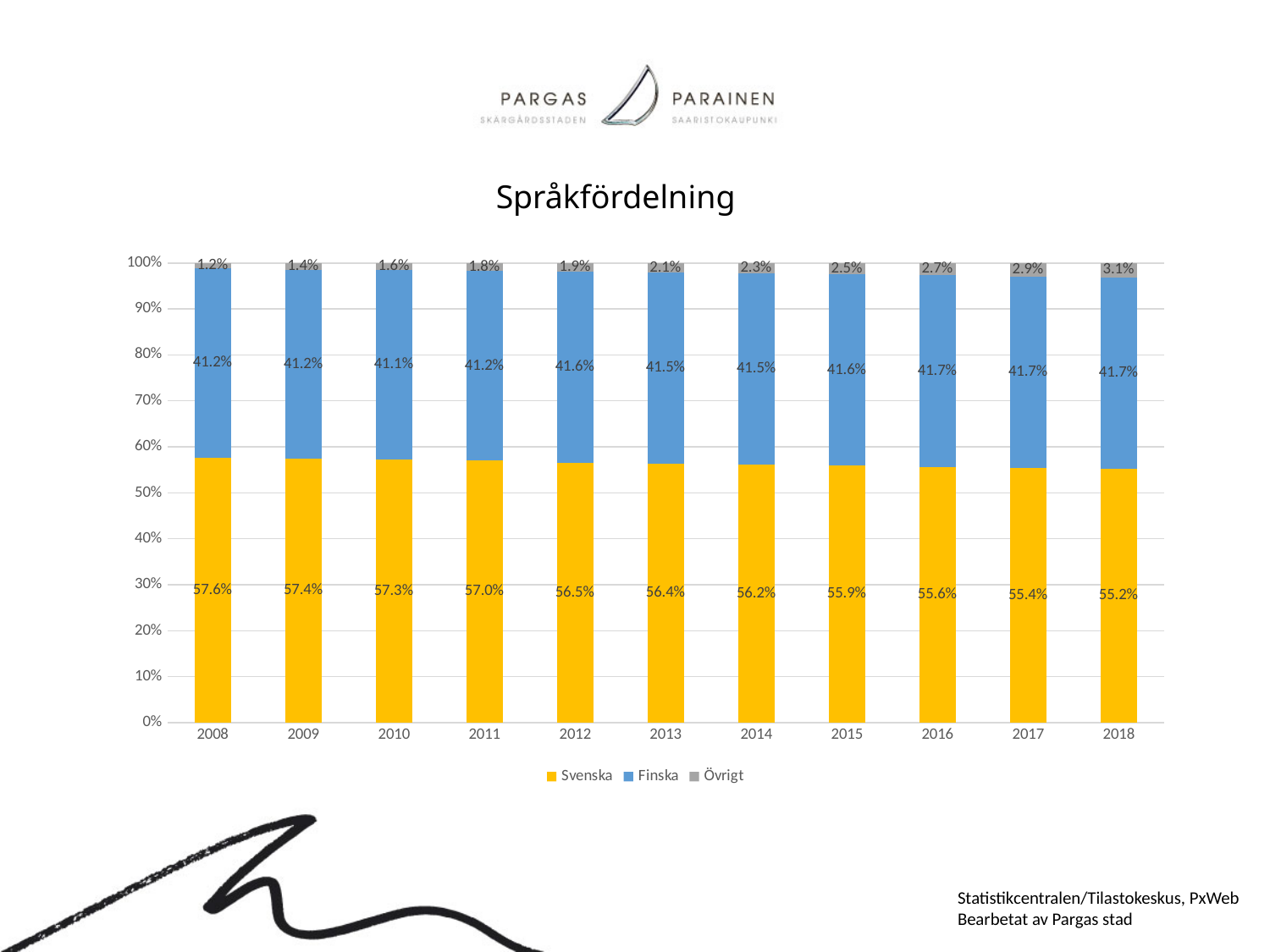
In which year is the Svenska share highest? 2008 What is the value for Övrigt in 2013? 2.1% What is the title of the chart? Språkfördelning What kind of chart is shown on the slide? Stacked bar chart How many years are shown on the x axis? 11 What is the value for Svenska in 2008? 57.6% What is the value for Finska in 2018? 41.7% Which is larger in 2015: the Svenska share or the Finska share? Svenska How many series does the legend list? 3 Does the Övrigt share rise or fall from 2008 to 2018? Rise What is the difference between the Svenska share in 2008 and in 2018? 2.4% In which year is the Övrigt share lowest? 2008